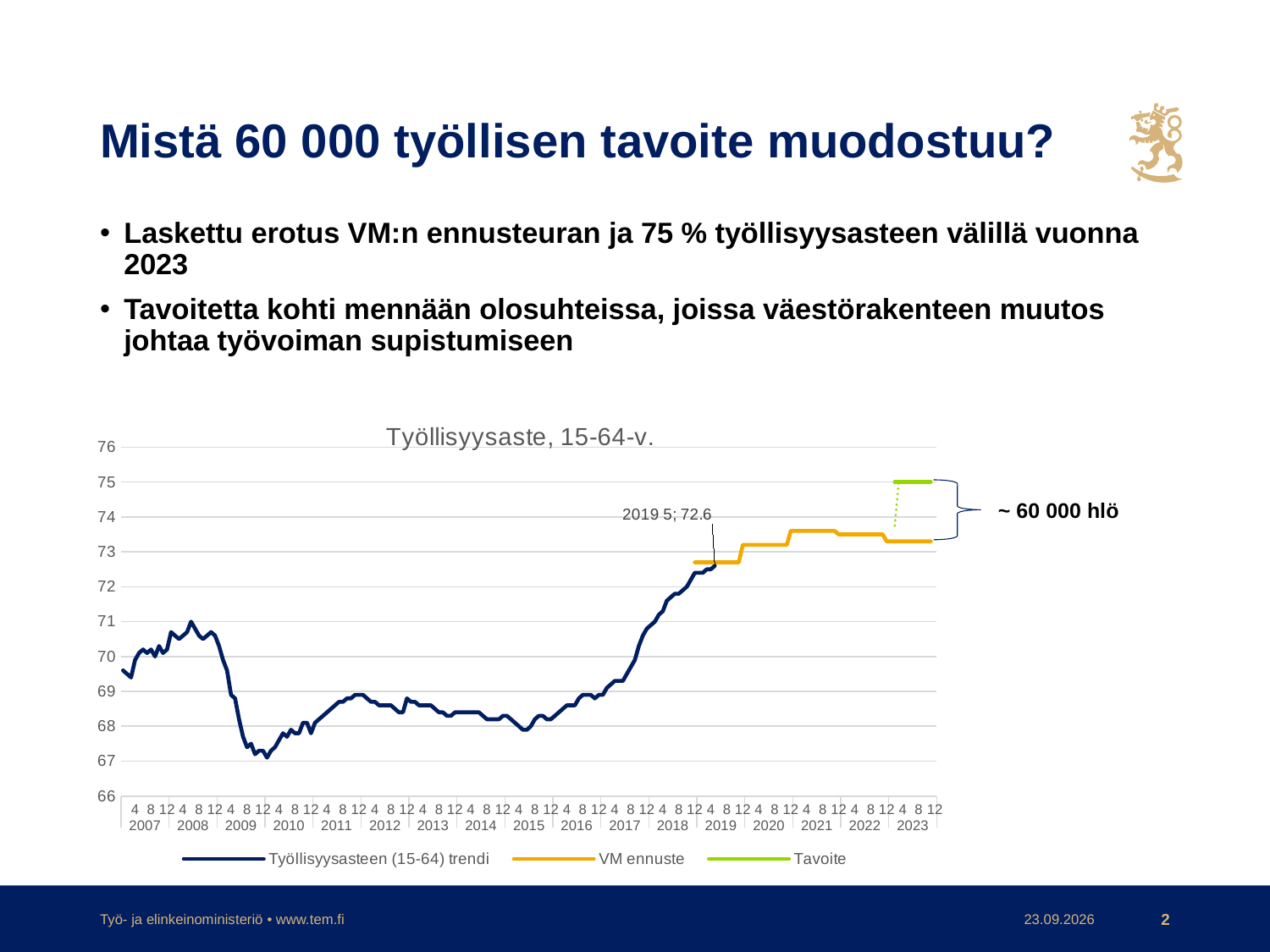
Does the Työllisyysasteen (15-64) trendi line rise or fall between 2015 and 2019? rise How many series does the chart legend list? 3 What kind of chart is shown on the slide? line chart How many years are labelled on the x axis of the chart? 17 At the end of 2023, which is higher: the Tavoite line or the VM ennuste line? Tavoite What is the title of the chart? Työllisyysaste, 15-64-v. Which series are listed in the chart legend? Työllisyysasteen (15-64) trendi, VM ennuste, Tavoite Is the lowest value of the Työllisyysasteen (15-64) trendi line greater or less than 68? less Is the value of the VM ennuste line at the end of 2023 greater or less than 74? less What value is printed on the data label at 2019 month 5 on the trend line? 72.6 Is the value of the Tavoite line greater or less than 74? greater Does the Työllisyysasteen (15-64) trendi line rise or fall between 2008 and 2009? fall